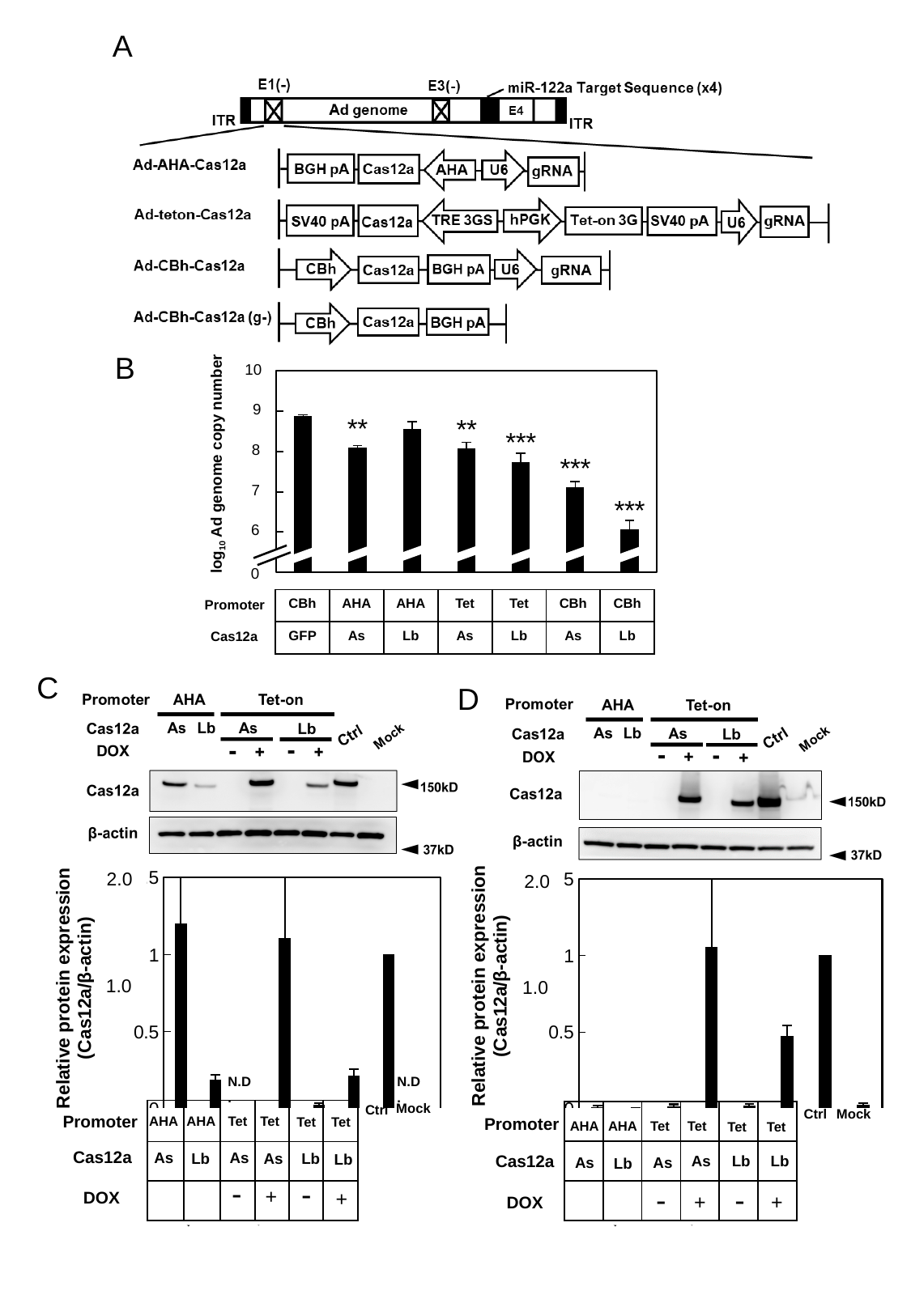
In panel B, which promoter/Cas12a combination has the lowest log10 Ad genome copy number? CBh / Lb In panel B, how many bars are plotted? 7 In panel B, is the value for the CBh / GFP bar greater or less than 8? greater In panel B, which is larger: the value for AHA / Lb or the value for CBh / As? AHA / Lb In the panel C bar chart, is the value for AHA / Lb greater or less than 0.5? less In panel B, is the value for the CBh / Lb bar greater or less than 7? less In panel B, what is the y-axis label? log10 Ad genome copy number What kind of chart is panel B? bar chart In panel B, which promoter/Cas12a combination has the highest log10 Ad genome copy number? CBh / GFP In the panel D bar chart, which is larger: the value for Tet / As with DOX (+) or the value for Tet / Lb with DOX (+)? Tet / As with DOX (+)